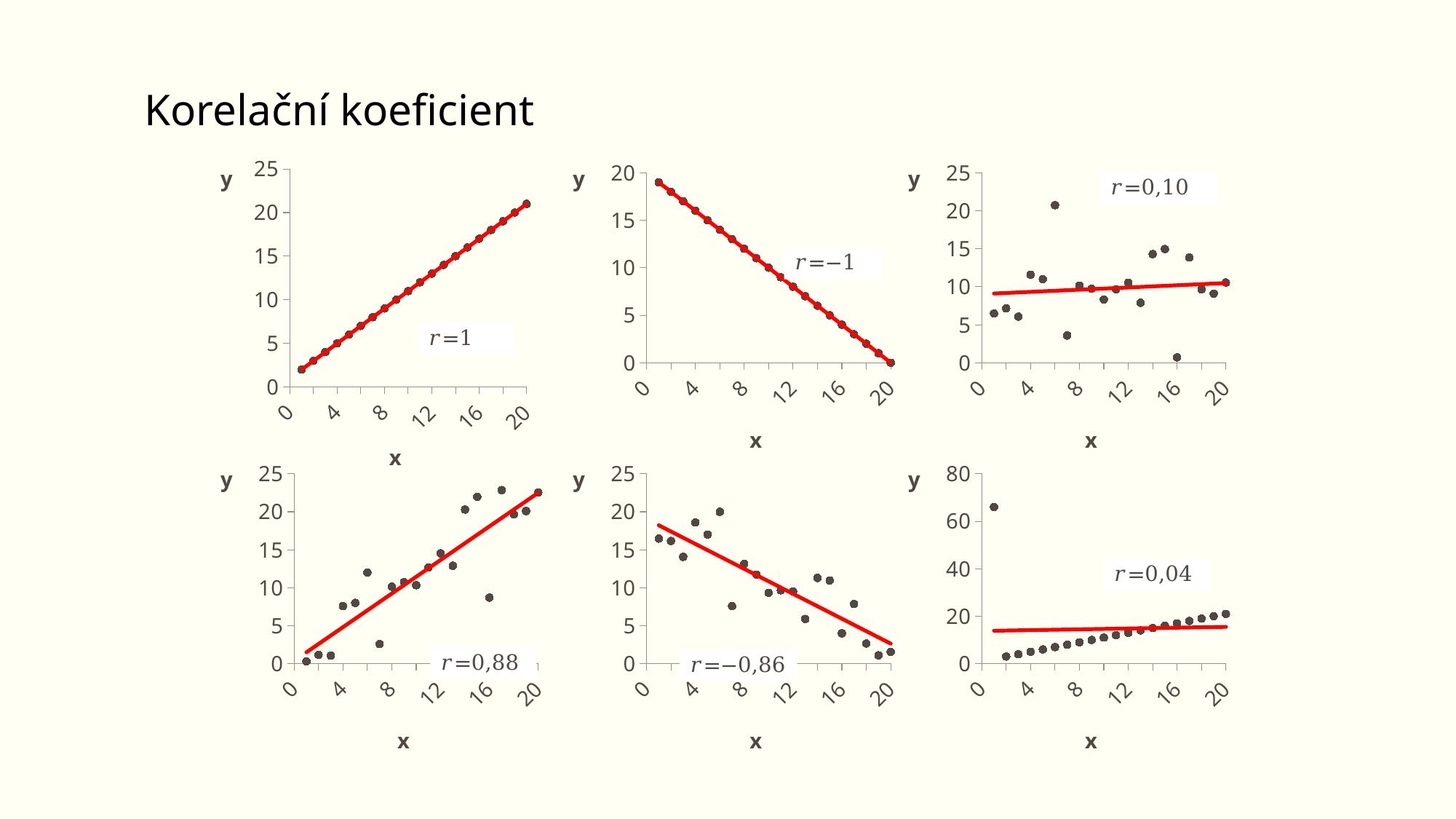
In the bottom-middle chart (r=−0,86), do the y values generally rise or fall as x increases? fall What correlation coefficient is printed on the top-right chart? r=0,10 In the bottom-middle chart (r=−0,86), is the y value at x=20 greater or less than 5? less What is the maximum value shown on the y axis of the bottom-right chart (r=0,04)? 80 In the top-left chart (r=1), do the y values rise or fall as x increases? rise In the bottom-right chart (r=0,04), is the y value of the highest point greater or less than 60? greater What kind of chart is the top-left chart (r=1)? scatter chart In the top-middle chart (r=−1), is the y value at x=8 greater or less than 10? greater In the bottom-left chart (r=0,88), do the y values generally rise or fall as x increases? rise